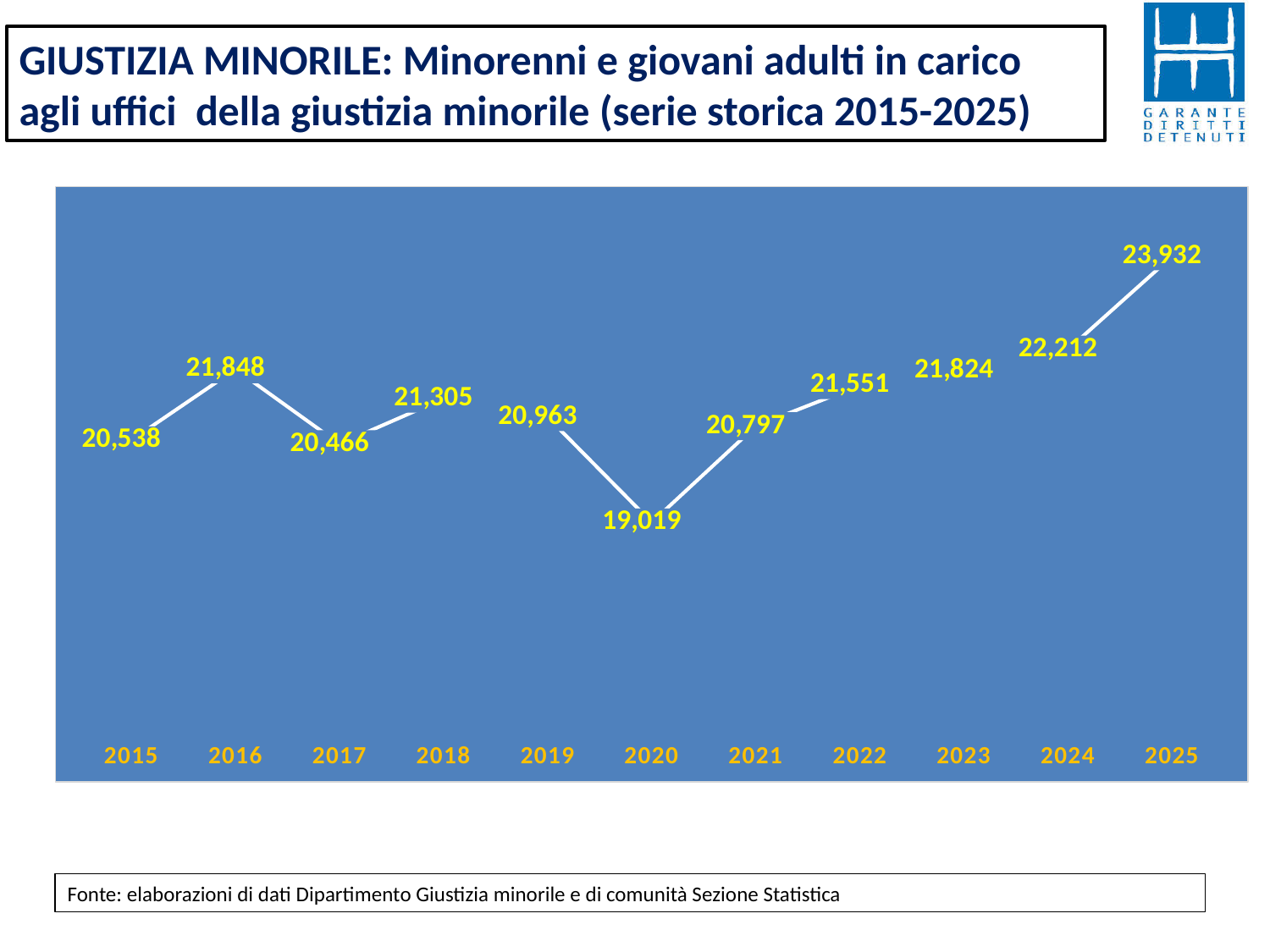
What is the value for 2025? 23,932 Which year has the lowest value? 2020 Which is larger, the value for 2016 or the value for 2017? 2016 How many years are plotted on the x axis? 11 What type of chart is shown on the slide? line chart Do the values rise or fall from 2020 to 2025? rise What is the difference between the values for 2025 and 2024? 1,720 What is the value for 2023? 21,824 What is the value for 2015? 20,538 What is the value for 2020? 19,019 Which year has the highest value? 2025 What is the difference between the values for 2019 and 2020? 1,944